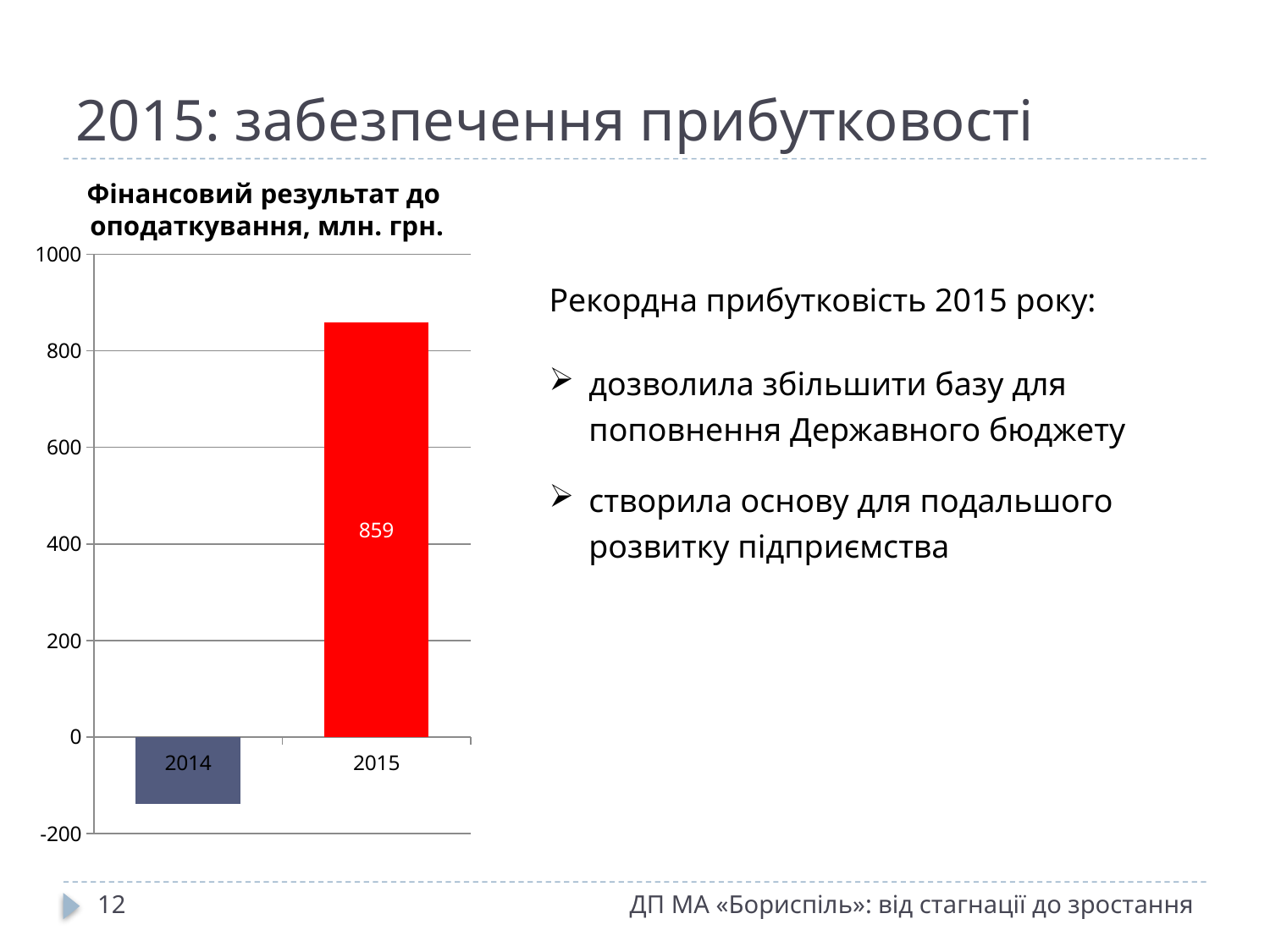
What colour is the bar for 2015? red Is the value for 2015 greater or less than 800? greater Which year has the highest financial result before taxation? 2015 What is the value for 2015 in the chart? 859 What kind of chart is shown on the slide? bar chart Is the value for 2014 greater or less than -200? greater Does the financial result rise or fall from 2014 to 2015? rise Which year has the lowest financial result before taxation? 2014 Is the value for 2014 greater or less than 0? less What is the title of the chart? Фінансовий результат до оподаткування, млн. грн. How many years are shown in the chart? 2 Which is larger, the value for 2014 or the value for 2015? 2015